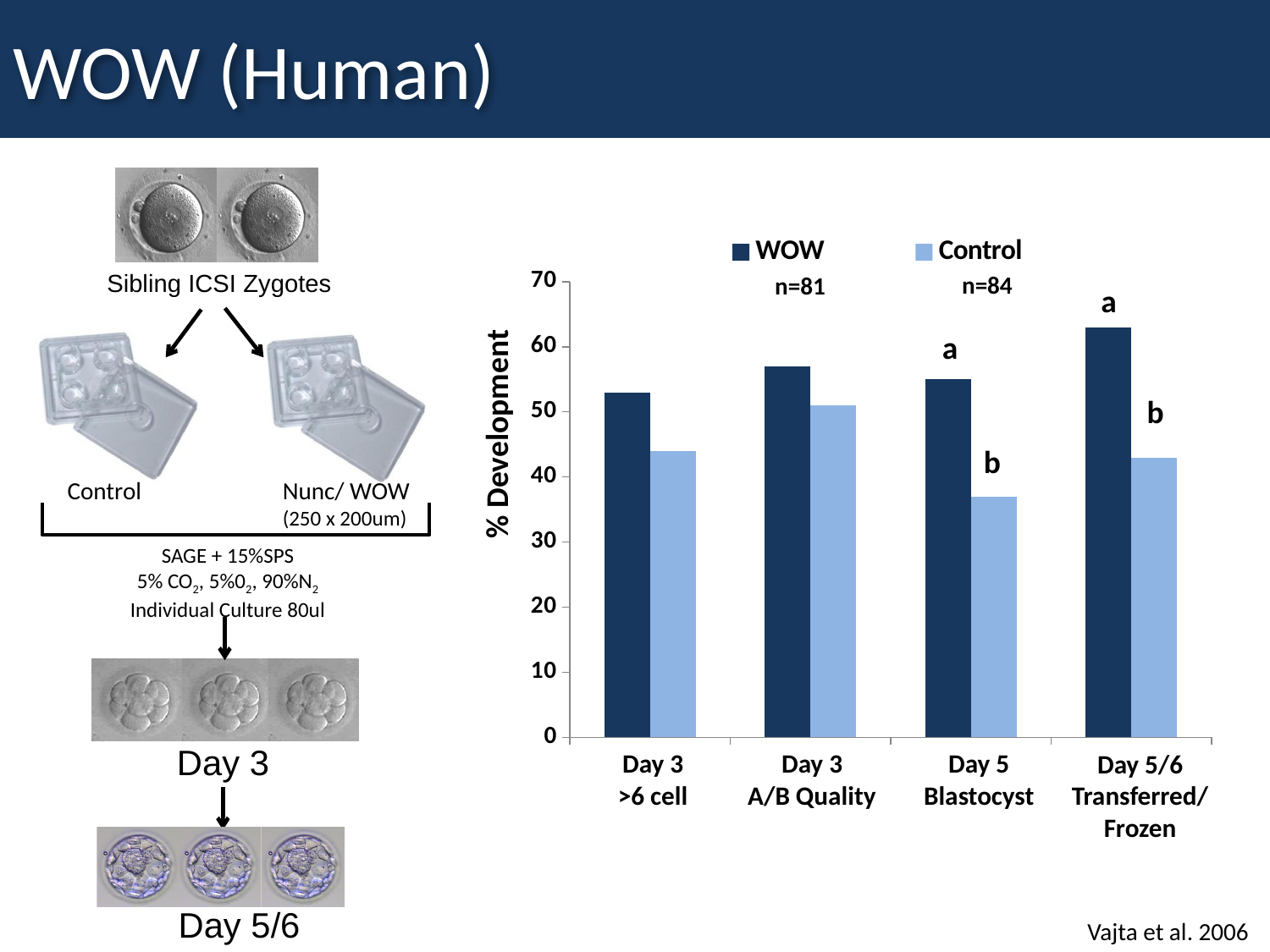
How many categories are shown along the x axis of the chart? 4 What kind of chart is shown on the slide? bar chart What is the label of the y axis of the chart? % Development Is the Control value for Day 3 >6 cell greater or less than 50? less Is the WOW value for Day 3 A/B Quality greater or less than 50? greater How many series does the chart legend list? 2 Is the WOW value for Day 5/6 Transferred/Frozen greater or less than 60? greater What sample size is shown for the WOW series in the legend? n=81 For Day 5 Blastocyst, which series has the larger value, WOW or Control? WOW Which category has the highest WOW value? Day 5/6 Transferred/Frozen Which category has the lowest Control value? Day 5 Blastocyst